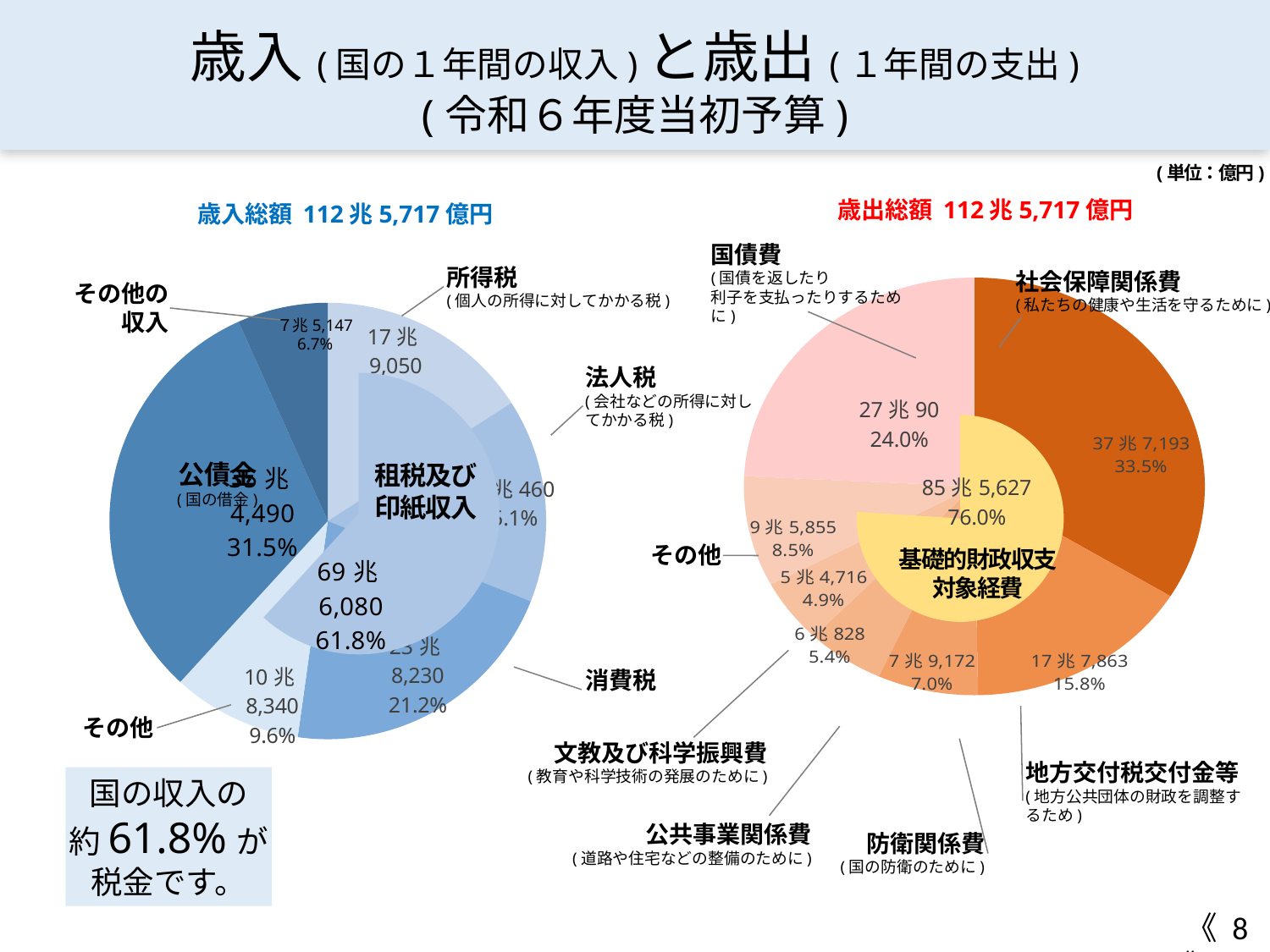
In the 歳入 chart on the left, what is the value for その他の収入? 7兆5,147 How many expenditure categories are labelled in the outer ring of the 歳出 chart on the right? 7 In the 歳出 chart on the right, which labelled expenditure category has the smallest share? 文教及び科学振興費 In the 歳出 chart on the right, what is the difference in value between 防衛関係費 and 公共事業関係費? 1兆8,344 In the 歳出 chart on the right, which expenditure category has the largest share? 社会保障関係費 In the 歳入 (revenue) chart on the left, what percentage share does 租税及び印紙収入 have? 61.8% In the 歳出 chart on the right, which is larger: 国債費 or 地方交付税交付金等? 国債費 In the 歳入 chart on the left, which category has the smallest share? その他の収入 What kind of chart is used for the 歳入 chart on the left? pie chart In the 歳出 chart on the right, what percentage share does 国債費 have? 24.0% In the 歳出 chart on the right, what is the value for 防衛関係費? 7兆9,172 In the 歳出 (expenditure) chart on the right, what is the value for 社会保障関係費? 37兆7,193